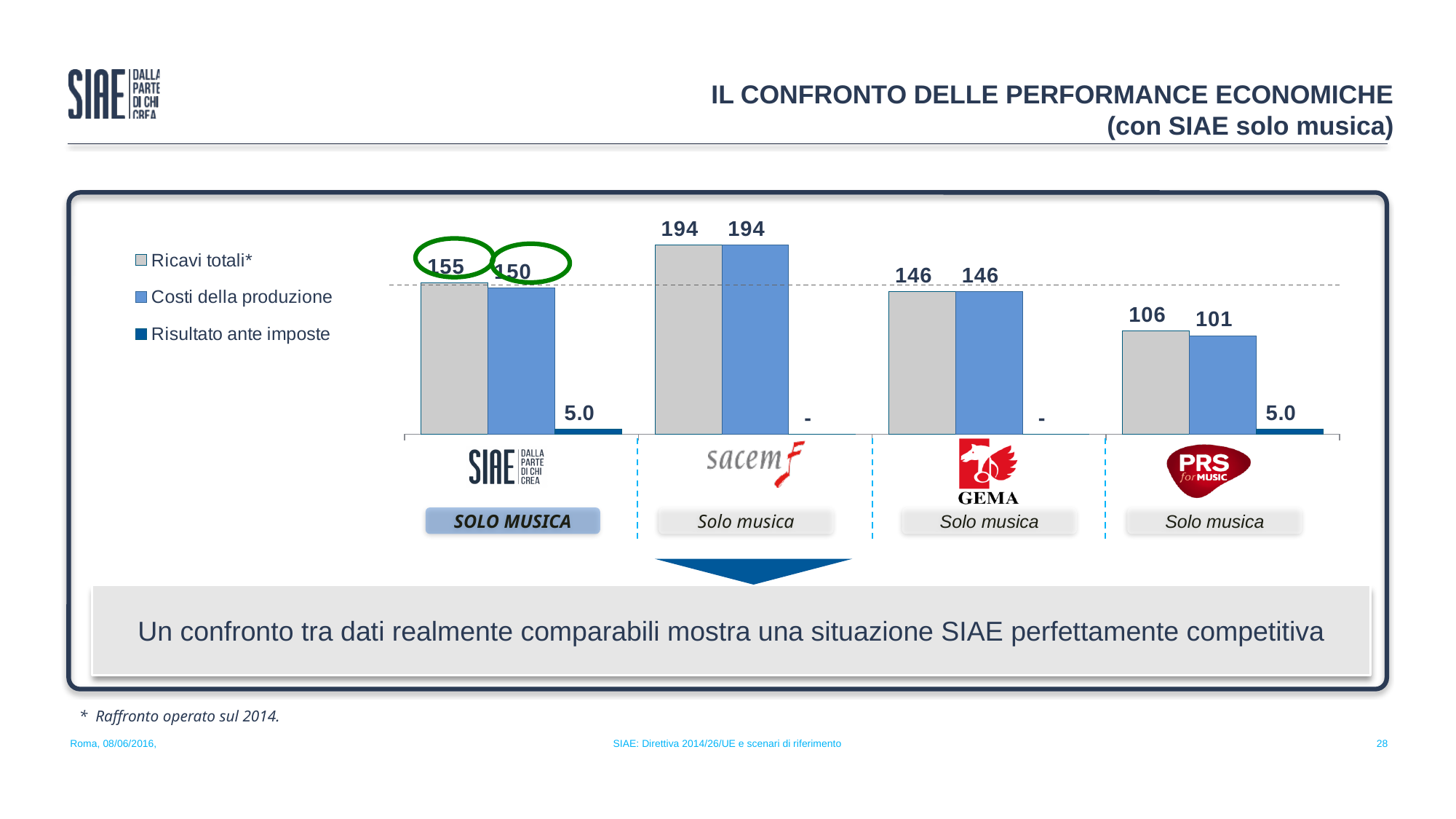
What is the value of Costi della produzione for PRS for Music? 101 What is the value of Costi della produzione for GEMA? 146 What is the value of Ricavi totali* for SIAE? 155 What is the difference between Ricavi totali* and Costi della produzione for SIAE? 5 How many organisations are compared in the chart? 4 Which is larger, the Ricavi totali* of SIAE or of GEMA? SIAE What kind of chart is shown on the slide? Bar chart What is the difference in Ricavi totali* between SACEM and GEMA? 48 Which organisation has the highest Ricavi totali*? SACEM What is the value of Risultato ante imposte for SIAE? 5.0 How many series does the legend list? 3 Which organisation has the lowest Costi della produzione? PRS for Music